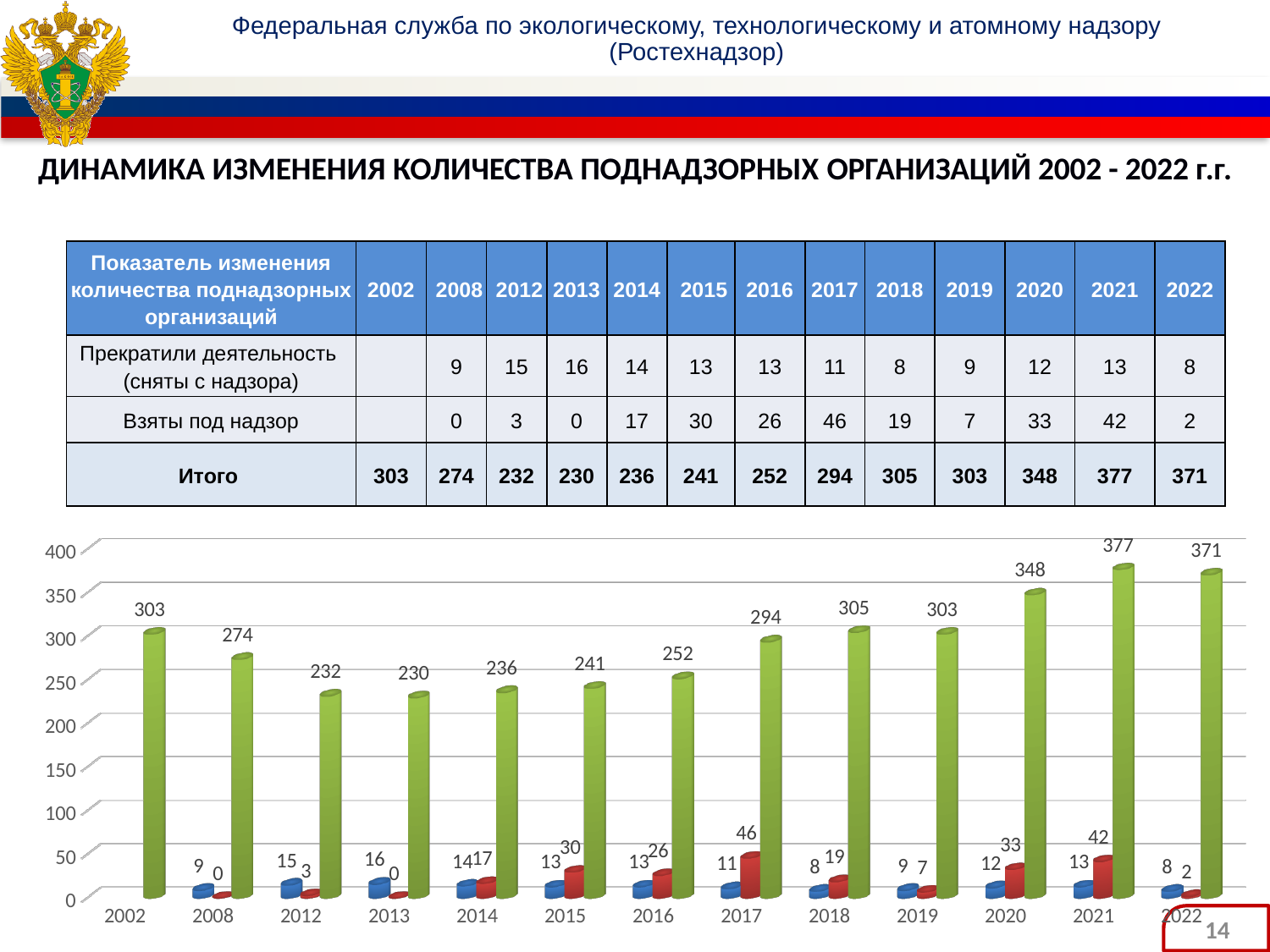
What is the difference between the red bar values for 2021 and 2022? 40 Is the green (total) bar for 2017 greater or less than 250? greater Which year has the lowest green (total) bar in the chart? 2013 Do the green (total) bars rise or fall from 2013 to 2018? rise What is the value of the red bar for 2017 in the chart? 46 What is the value of the green (total) bar for 2002 in the chart? 303 What is the value of the green (total) bar for 2021 in the chart? 377 Which year has the highest green (total) bar in the chart? 2021 What kind of chart is shown on the slide? bar chart What is the difference between the green (total) bar values for 2021 and 2022? 6 How many years are shown on the x axis of the chart? 13 Which is larger in the chart: the green (total) bar for 2020 or for 2019? 2020